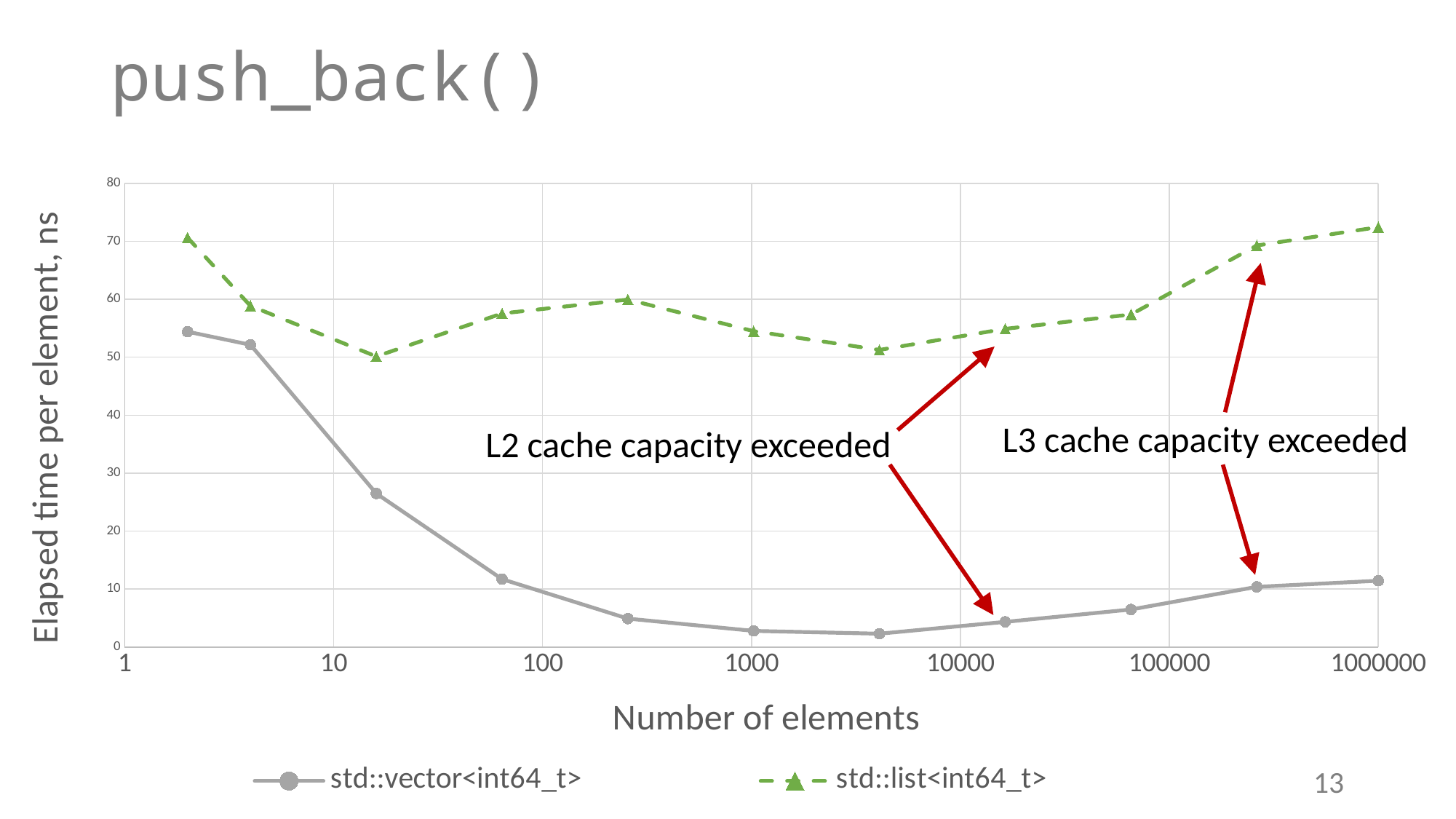
Between which two x-axis ticks does the std::vector<int64_t> series reach its lowest value? 1000 and 10000 Does the std::vector<int64_t> series rise or fall between 1 and 100 elements? fall What is the title of the chart? push_back() What kind of chart is shown on the slide? line chart How many series does the legend list? 2 Is the value for std::list<int64_t> at 1000000 elements greater or less than 70? greater Which series has the higher elapsed time per element at 1000000 elements? std::list<int64_t> Is the value for std::list<int64_t> at 1000000 elements greater or less than 80? less Is the leftmost value for std::vector<int64_t> greater or less than 50? greater How many data points are plotted for the std::vector<int64_t> series? 11 What is the label of the y axis? Elapsed time per element, ns